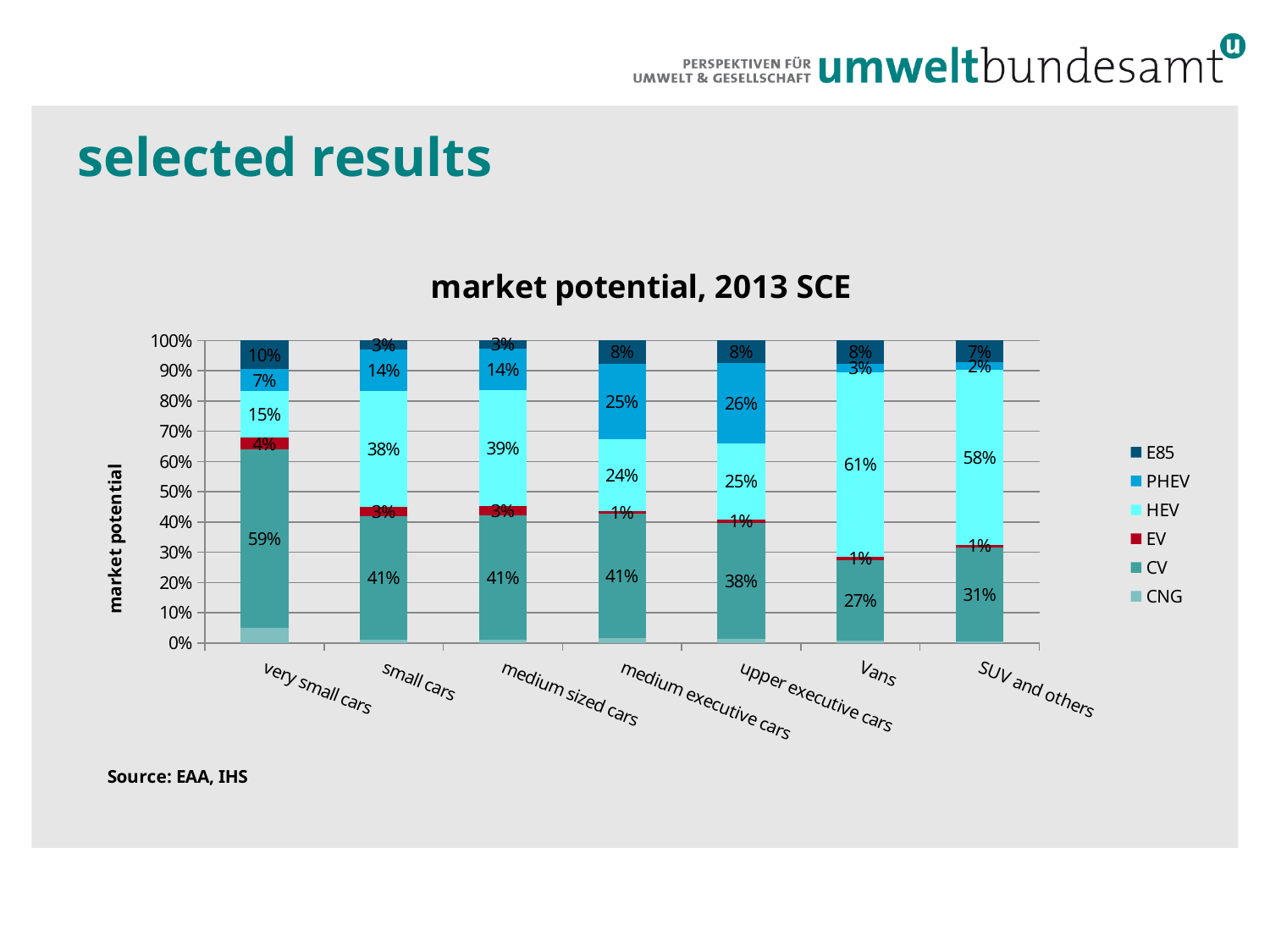
What kind of chart is shown on the slide? stacked bar chart What is the CV share for very small cars? 59% How many vehicle categories are shown on the x axis? 7 Which category has the highest HEV share? Vans What is the HEV share for Vans? 61% What is the PHEV share for upper executive cars? 26% What is the difference between the HEV share for Vans and the HEV share for SUV and others? 3 percentage points What is the title of the chart? market potential, 2013 SCE Which is larger, the PHEV share for small cars or the PHEV share for medium executive cars? medium executive cars What is the E85 share for SUV and others? 7% How many series does the legend list? 6 Which category has the lowest CV share? Vans